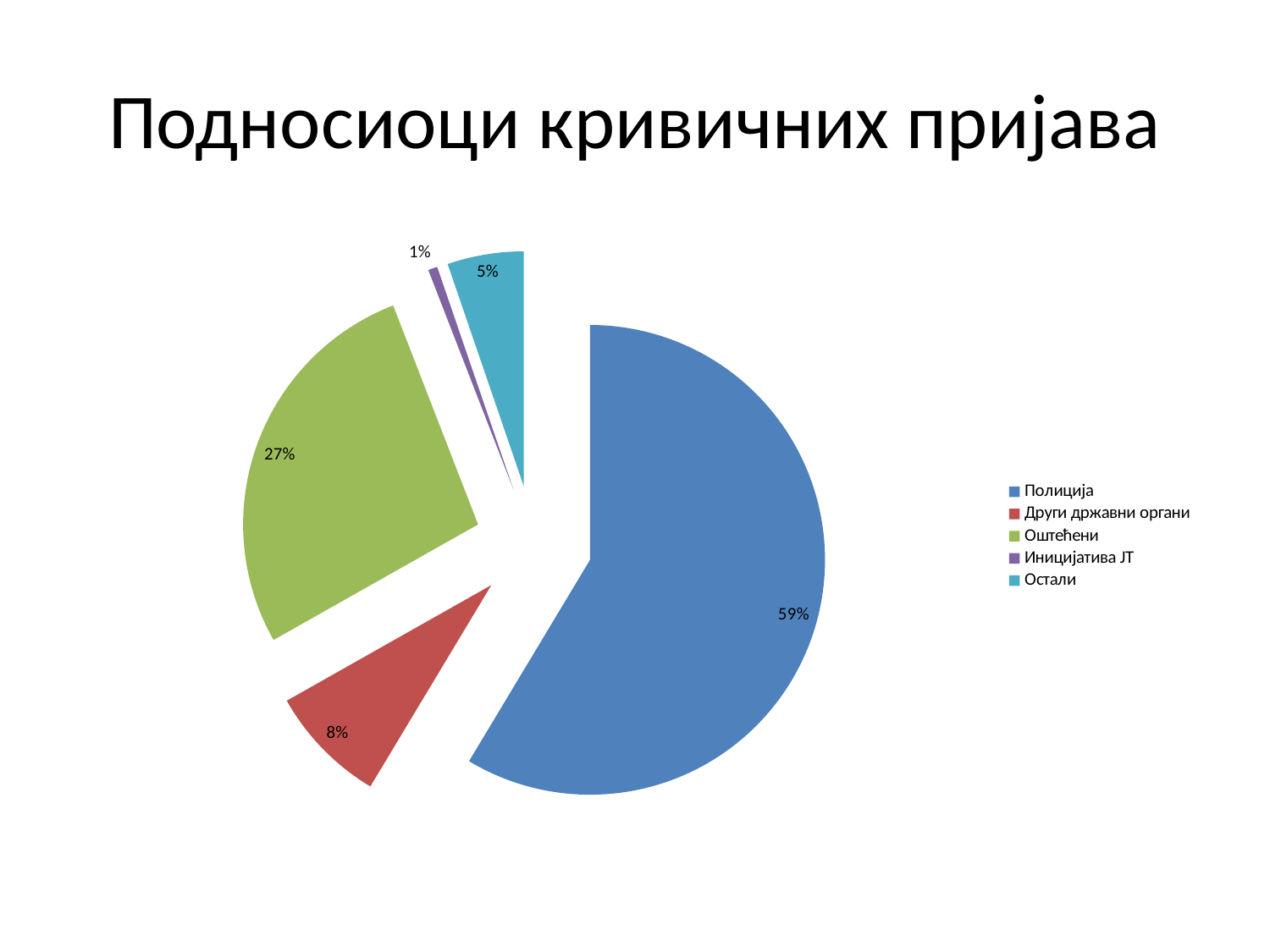
What share of the pie does Оштећени have? 27% What share of the pie does Иницијатива ЈТ have? 1% What share of the pie does Полиција have? 59% Which category has the smallest slice of the pie? Иницијатива ЈТ What is the difference in percentage points between Полиција and Оштећени? 32 What kind of chart is shown on the slide? Pie chart How many categories are shown in the pie chart? 5 What is the title of the slide? Подносиоци кривичних пријава Which category has the largest slice of the pie? Полиција Which is larger, the share for Други државни органи or the share for Остали? Други државни органи